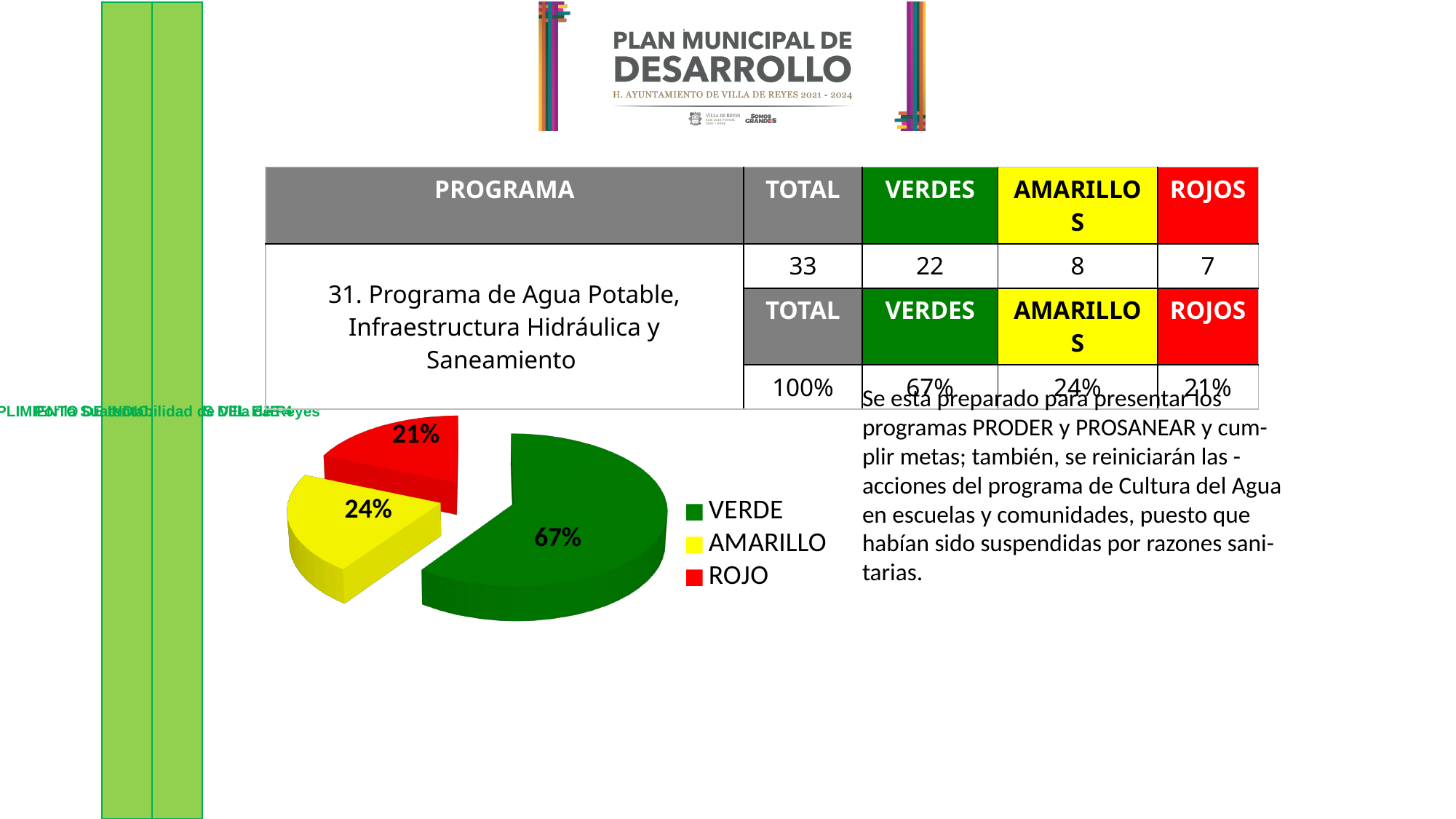
Which slice of the pie chart is the smallest? ROJO What is the difference in percentage points between the AMARILLO and ROJO slices? 3 percentage points What percentage does the VERDE slice of the pie chart show? 67% How many entries does the legend of the pie chart list? 3 What kind of chart is shown on the slide? Pie chart What is the difference in percentage points between the VERDE and AMARILLO slices? 43 percentage points What percentage does the AMARILLO slice of the pie chart show? 24% What colour is the ROJO slice in the pie chart? Red Which is larger in the pie chart, VERDE or AMARILLO? VERDE How many slices does the pie chart have? 3 Which slice of the pie chart is the largest? VERDE What percentage does the ROJO slice of the pie chart show? 21%